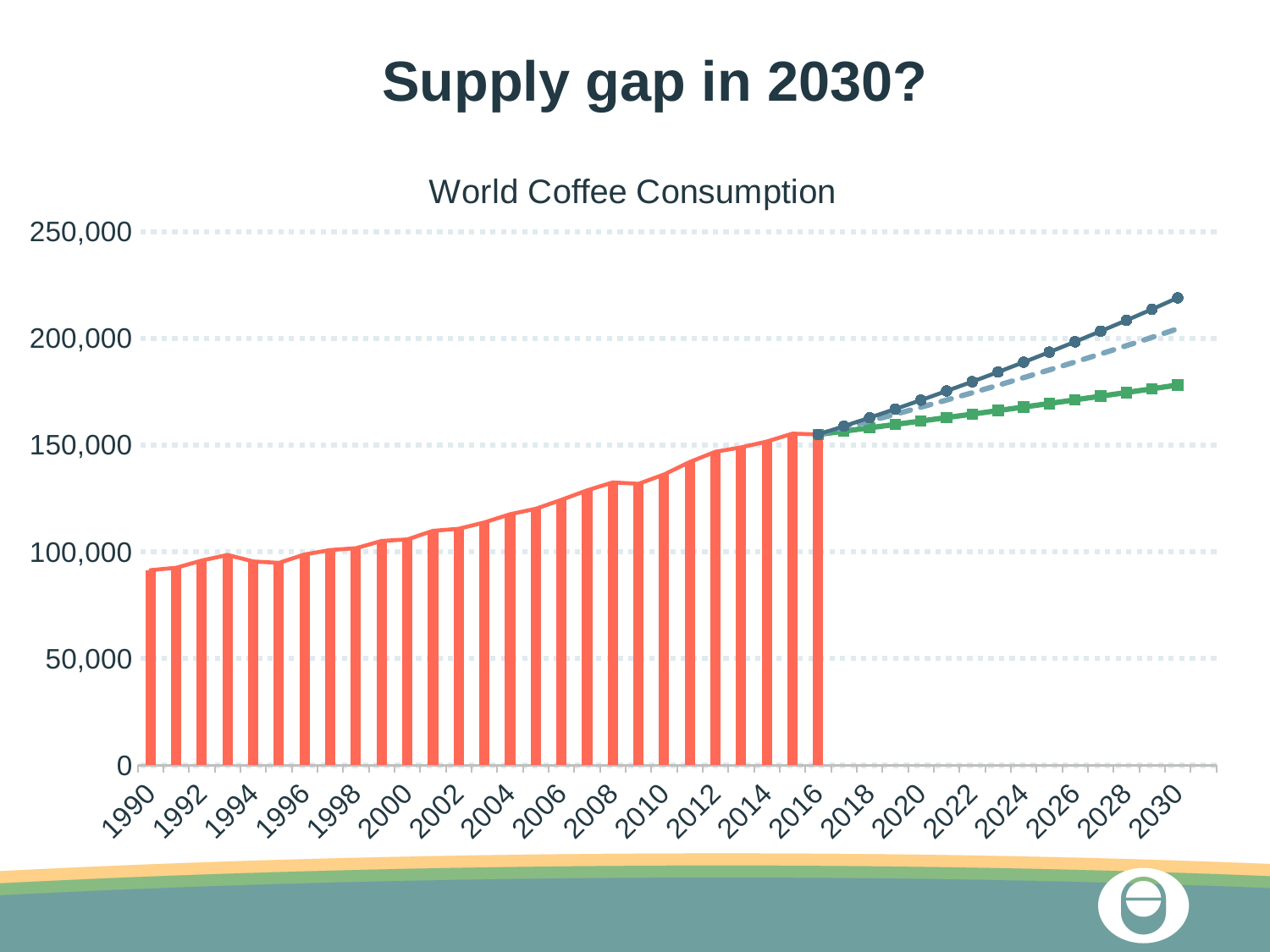
In 2030, is the green projection line with square markers greater or less than 200,000? less In 2030, is the highest projection line (dark blue with circle markers) greater or less than 200,000? greater What is the title of the chart on the slide? World Coffee Consumption Is the World Coffee Consumption value for 2004 greater or less than 150,000? less What kind of chart is used to show World Coffee Consumption from 1990 to 2016? Bar chart Which is larger, World Coffee Consumption in 2000 or in 2010? 2010 Do the World Coffee Consumption bars rise or fall from 1990 to 2016? rise How many bars are plotted in the World Coffee Consumption chart? 27 Which year has the tallest bar in the World Coffee Consumption chart? 2015